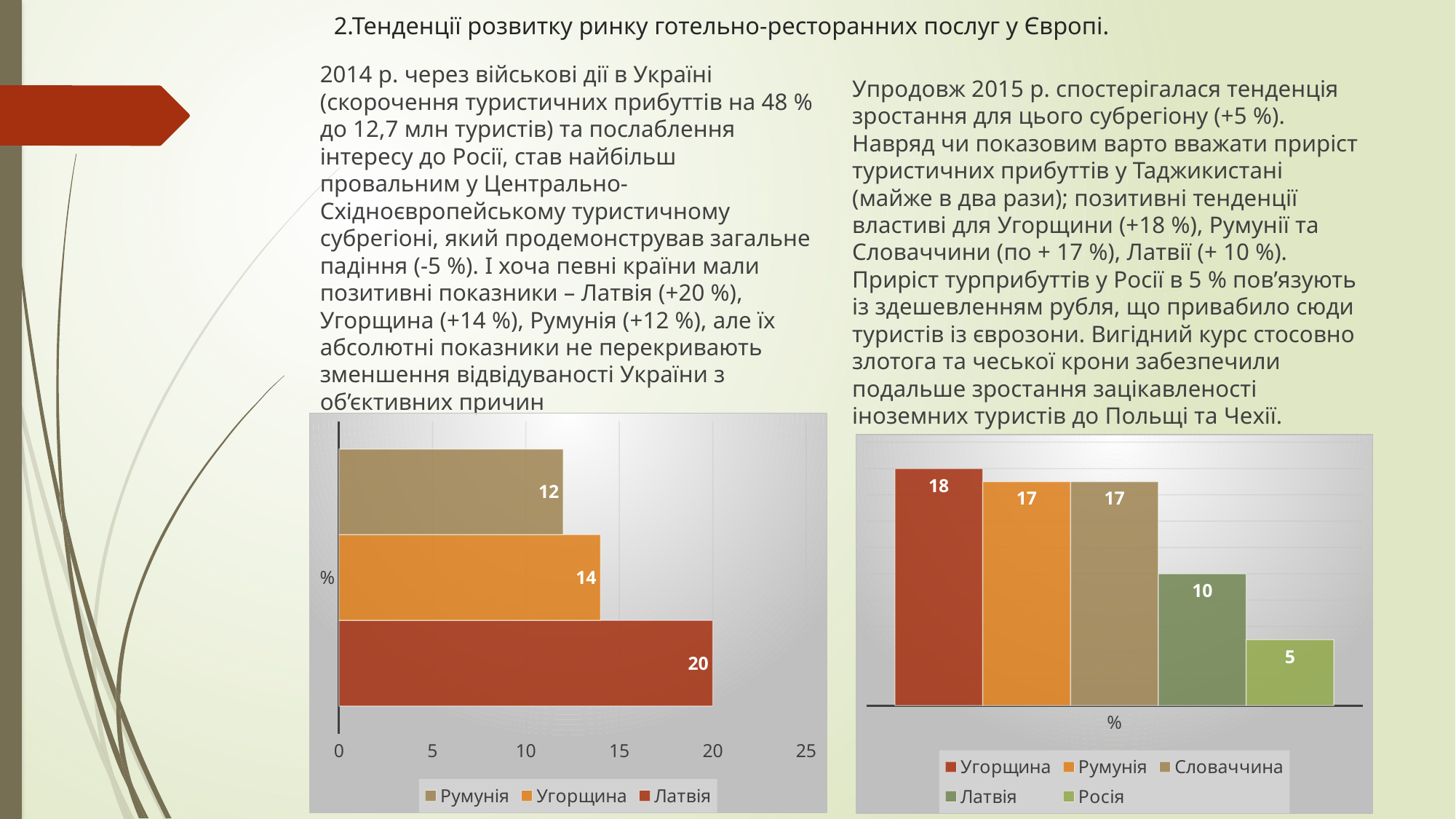
In the right chart, what is the difference between the values for Угорщина and Латвія? 8 In the right chart, what is the value for Словаччина? 17 In the right chart, what is the value for Росія? 5 In the left chart, what is the value for Латвія? 20 In the left chart, what is the value for Угорщина? 14 In the right chart, which is larger, the value for Латвія or the value for Росія? Латвія In the right chart, which country has the highest value? Угорщина In the left chart, which country has the lowest value? Румунія What kind of chart is the left chart? bar chart In the left chart, how many entries does the legend list? 3 In the left chart, what is the difference between the values for Латвія and Румунія? 8 In the right chart, how many bars are plotted? 5